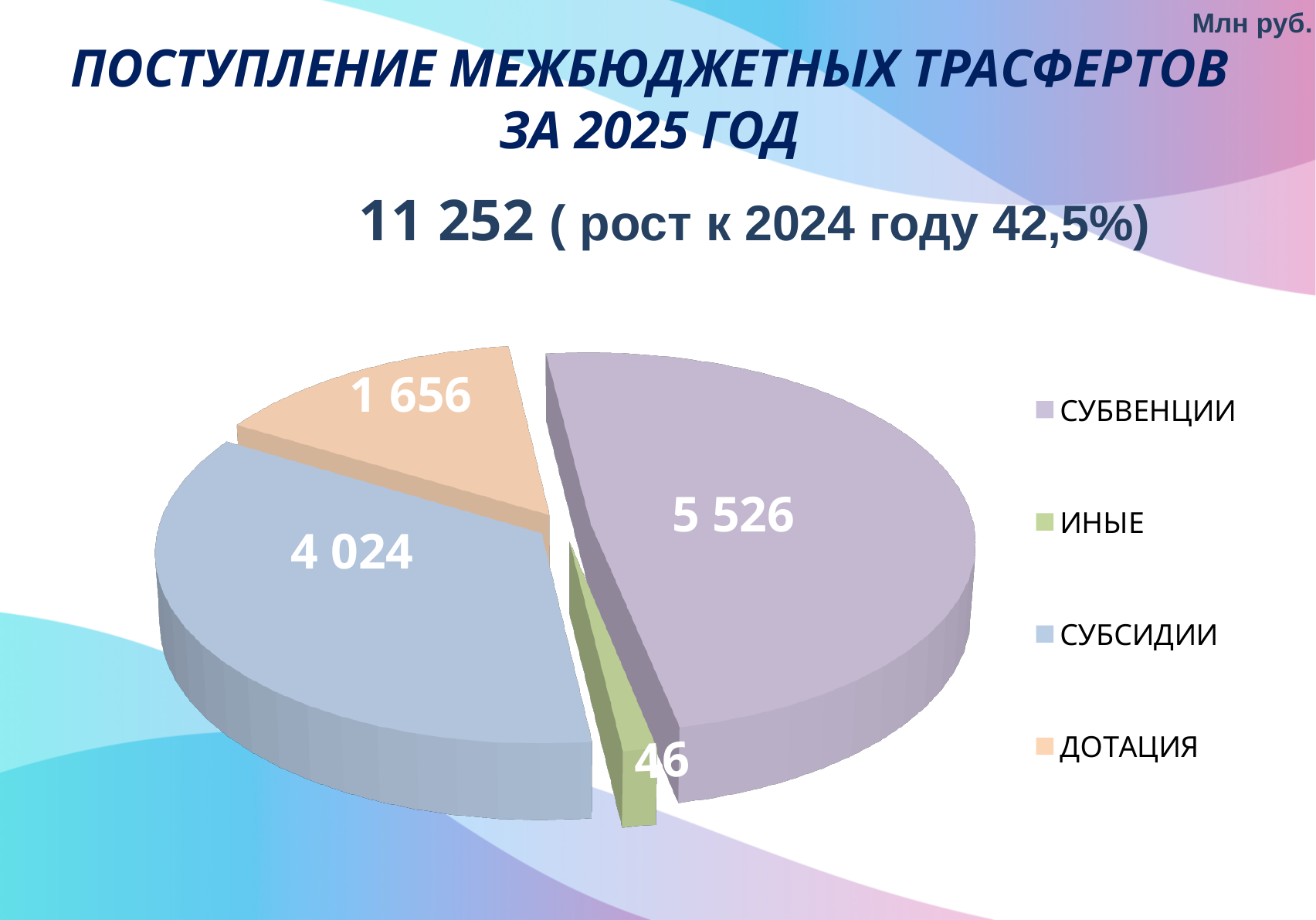
How many slices does the pie chart have? 4 Which category has the largest slice in the pie chart? СУБВЕНЦИИ What total value is shown above the pie chart for 2025? 11 252 What is the difference between the values for СУБВЕНЦИИ and СУБСИДИИ? 1 502 What is the value for ИНЫЕ in the pie chart? 46 Which is larger, the value for СУБСИДИИ or the value for ДОТАЦИЯ? СУБСИДИИ What is the value for СУБСИДИИ in the pie chart? 4 024 Which category has the smallest slice in the pie chart? ИНЫЕ What share of the total 11 252 does СУБВЕНЦИИ represent, to the nearest whole percent? 49% What kind of chart is shown on the slide? Pie chart What is the value for ДОТАЦИЯ in the pie chart? 1 656 What is the value for СУБВЕНЦИИ in the pie chart? 5 526